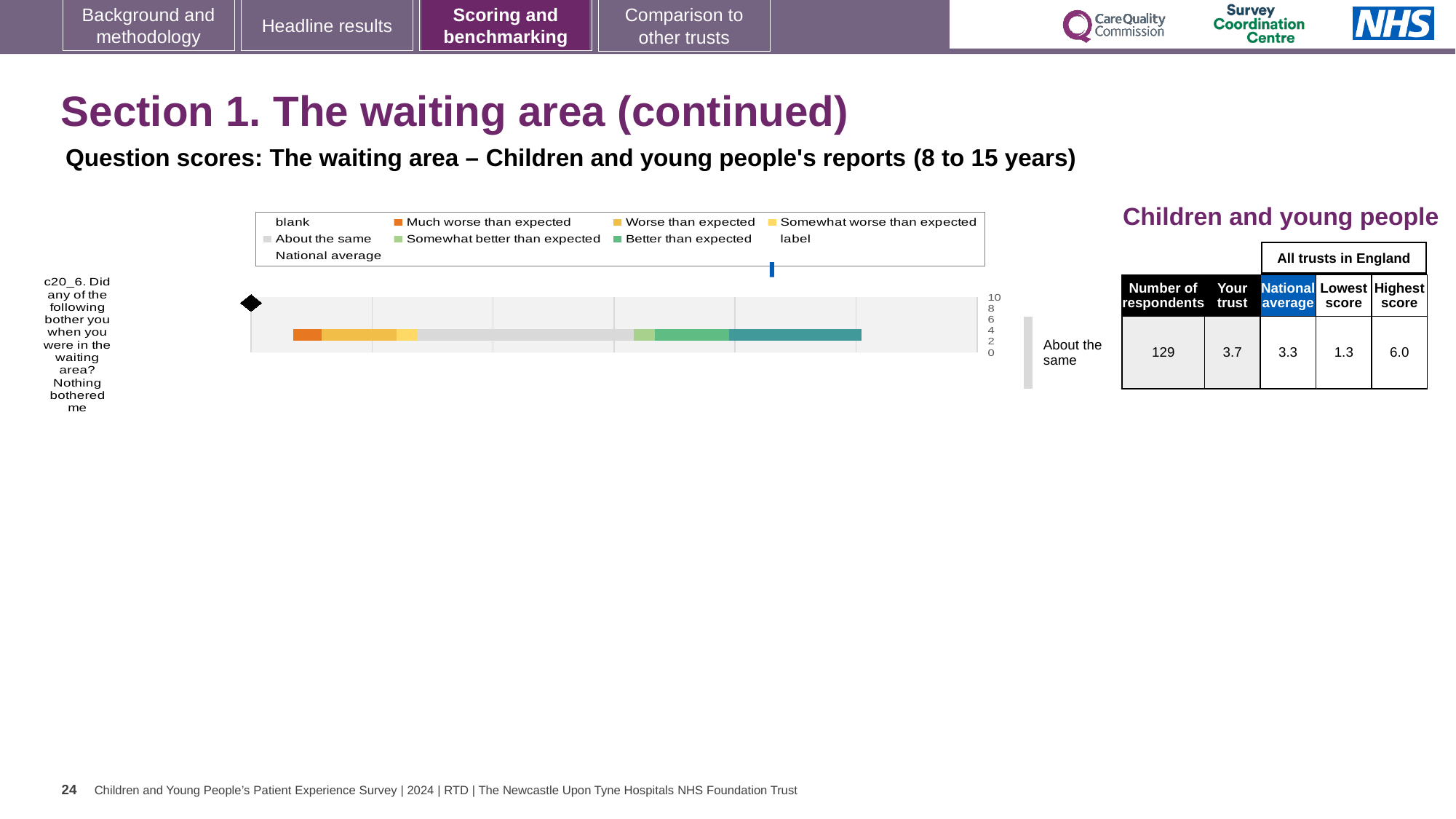
What is the highest value shown on the chart's score axis? 10 What is the difference between the 'Your trust' score and the national average for question c20_6? 0.4 What is the difference between the highest and lowest scores among all trusts in England for question c20_6? 4.7 What is the 'Your trust' score for question c20_6 in the Children and young people table? 3.7 What benchmark category label is shown to the right of the bar for question c20_6? About the same What kind of chart is used to show the benchmarking result for question c20_6? bar chart What is the national average score for question c20_6? 3.3 How many respondents answered question c20_6? 129 What is the highest score among all trusts in England for question c20_6? 6.0 Which is larger for question c20_6: the 'Your trust' score or the national average? Your trust How many survey questions are plotted in the benchmarking chart? 1 What is the lowest score among all trusts in England for question c20_6? 1.3